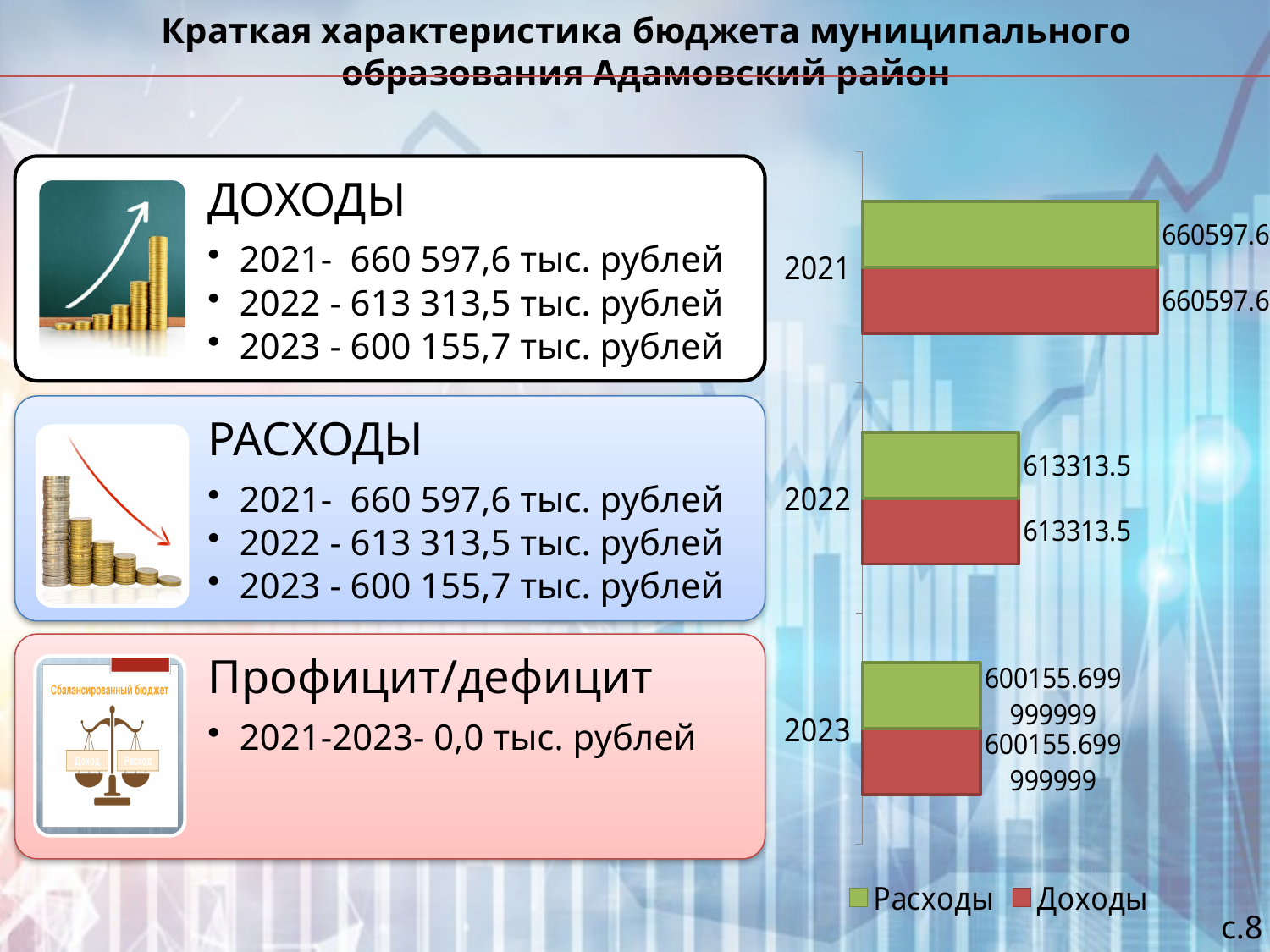
Which is larger: Доходы in 2021 or Доходы in 2022? 2021 What is the value of Доходы for 2022? 613313.5 What kind of chart is shown on the slide? bar chart Which year has the highest value for Доходы? 2021 Do the values for Доходы rise or fall from 2021 to 2023? fall What is the value of Расходы for 2021? 660597.6 What is the difference between Расходы in 2021 and Расходы in 2022? 47284.1 How many series does the legend list? 2 Which year has the lowest value for Расходы? 2023 What is the difference between Расходы and Доходы in 2022? 0 What colour are the Доходы bars? red How many years are shown on the chart? 3